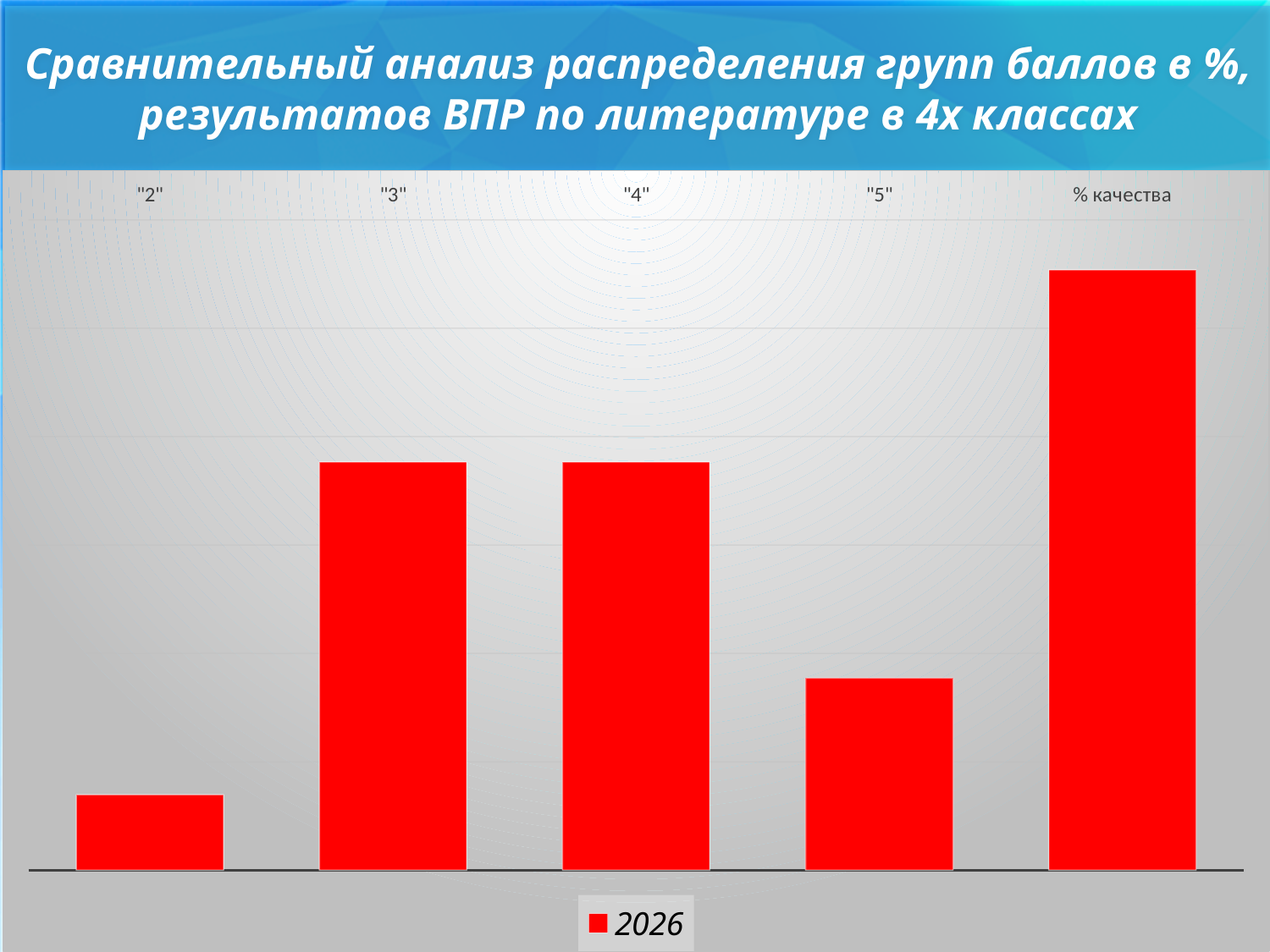
Which is larger, the bar for "4" or the bar for % качества? % качества How many series does the chart legend list? 1 How many categories are shown on the x axis of the chart? 5 Which is larger, the bar for "2" or the bar for "4"? "4" Which category has the lowest bar in the chart? "2" Which is larger, the bar for "2" or the bar for "5"? "5" What kind of chart is shown on the slide? bar chart Which category has the highest bar in the chart? % качества What colour are the bars in the chart? red What series name is shown in the chart legend? 2026